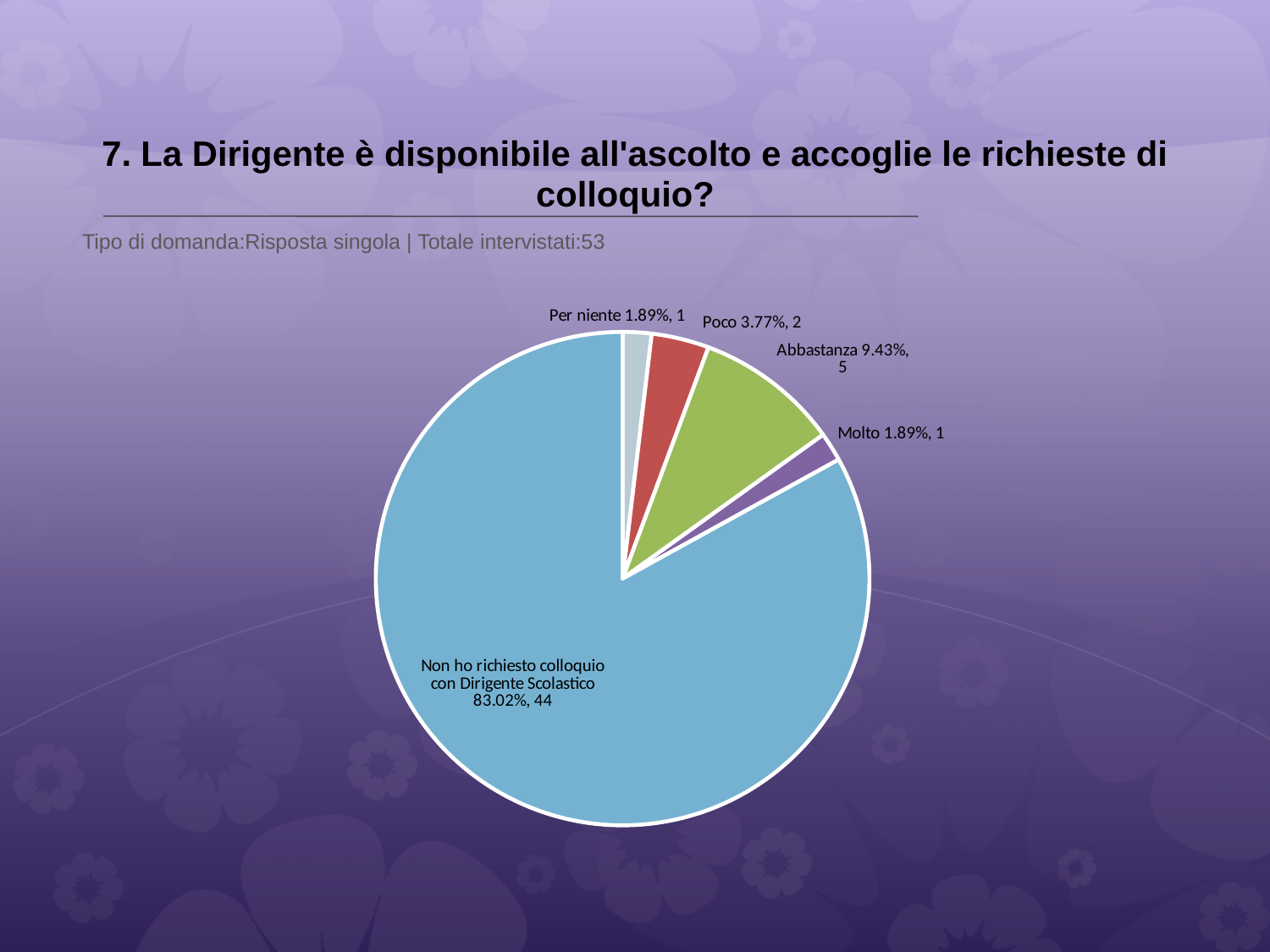
What colour is the 'Abbastanza' slice? green Which is larger, the count for 'Abbastanza' or the count for 'Poco'? Abbastanza What percentage is shown for 'Per niente'? 1.89% What percentage is shown for 'Poco'? 3.77% What is the difference in respondent count between 'Abbastanza' and 'Poco'? 3 How many respondents answered 'Molto'? 1 How many respondents answered 'Abbastanza'? 5 What kind of chart is shown on the slide? pie chart Which category has the largest slice? Non ho richiesto colloquio con Dirigente Scolastico How many slices does the pie chart have? 5 What is the total number of respondents stated on the slide? 53 What percentage share does the 'Non ho richiesto colloquio con Dirigente Scolastico' slice have? 83.02%